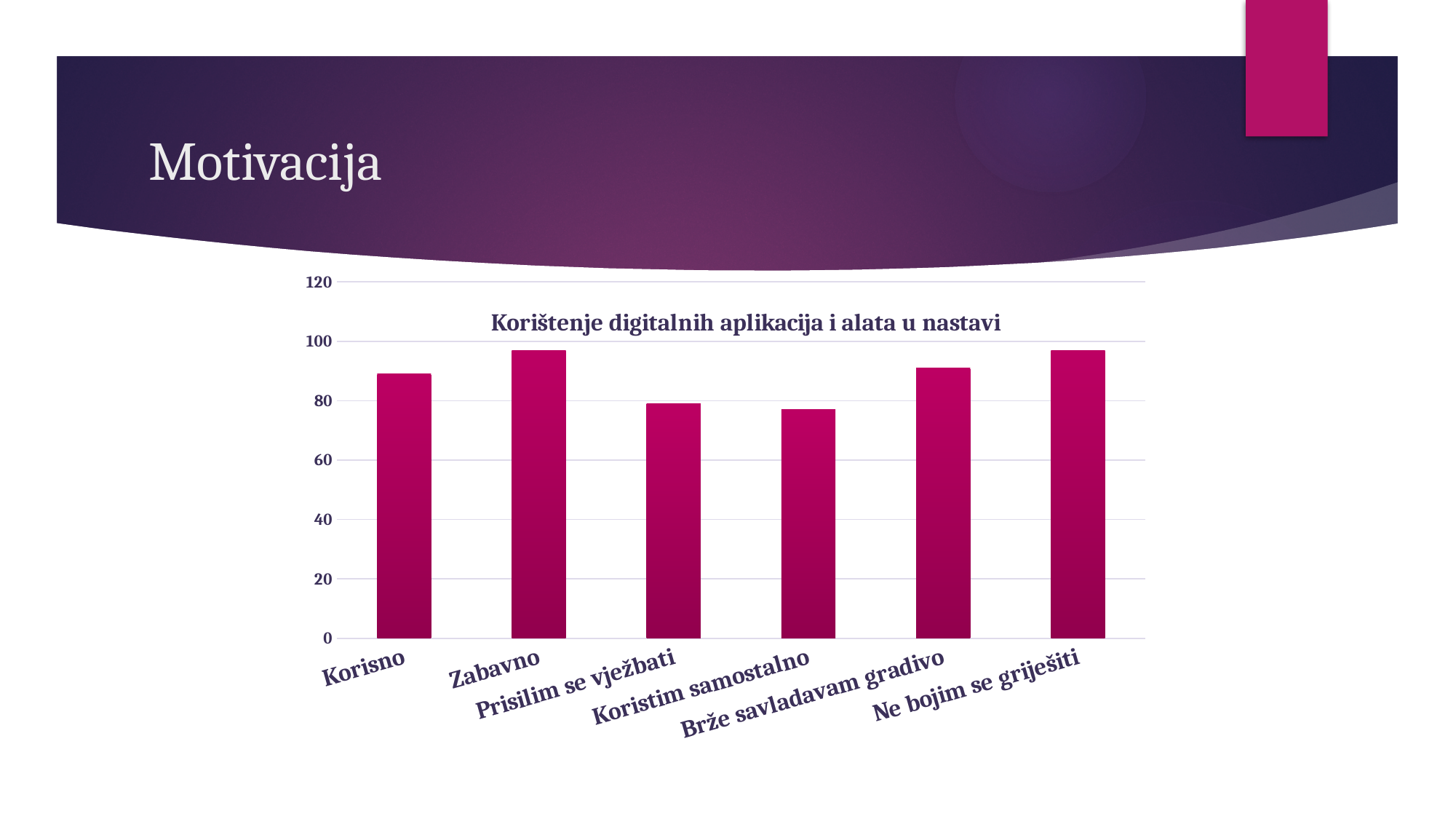
Which is larger, the value for Zabavno or the value for Koristim samostalno? Zabavno Is the value for Korisno greater or less than 80? greater What kind of chart is shown on the slide? bar chart Which is larger, the value for Brže savladavam gradivo or the value for Koristim samostalno? Brže savladavam gradivo How many categories are shown on the x axis of the chart? 6 Which is larger, the value for Korisno or the value for Prisilim se vježbati? Korisno Is the value for Zabavno greater or less than 100? less Is the value for Prisilim se vježbati greater or less than 60? greater What is the title of the chart? Korištenje digitalnih aplikacija i alata u nastavi